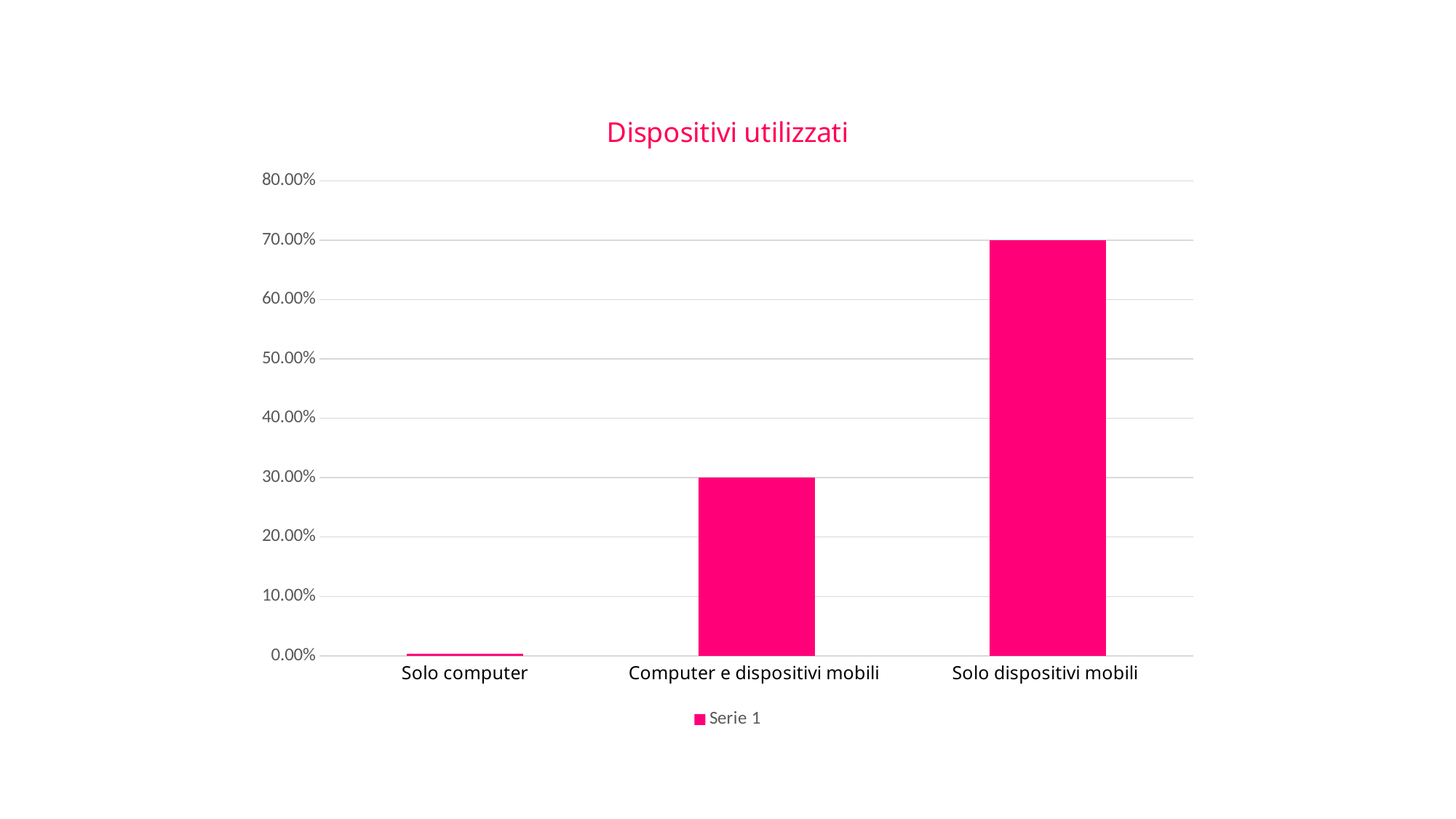
What kind of chart is shown? bar chart Which category has the highest value? Solo dispositivi mobili Which category has the lowest value? Solo computer Is the value for Solo dispositivi mobili greater or less than 60.00%? greater Which is larger, the value for Computer e dispositivi mobili or the value for Solo computer? Computer e dispositivi mobili What is the difference between the values for Solo dispositivi mobili and Computer e dispositivi mobili? 40.00% Is the value for Solo computer greater or less than 10.00%? less What is the value for Solo dispositivi mobili? 70.00% How many series does the legend list? 1 What is the value for Computer e dispositivi mobili? 30.00% How many categories are shown on the x axis? 3 What is the title of the chart? Dispositivi utilizzati